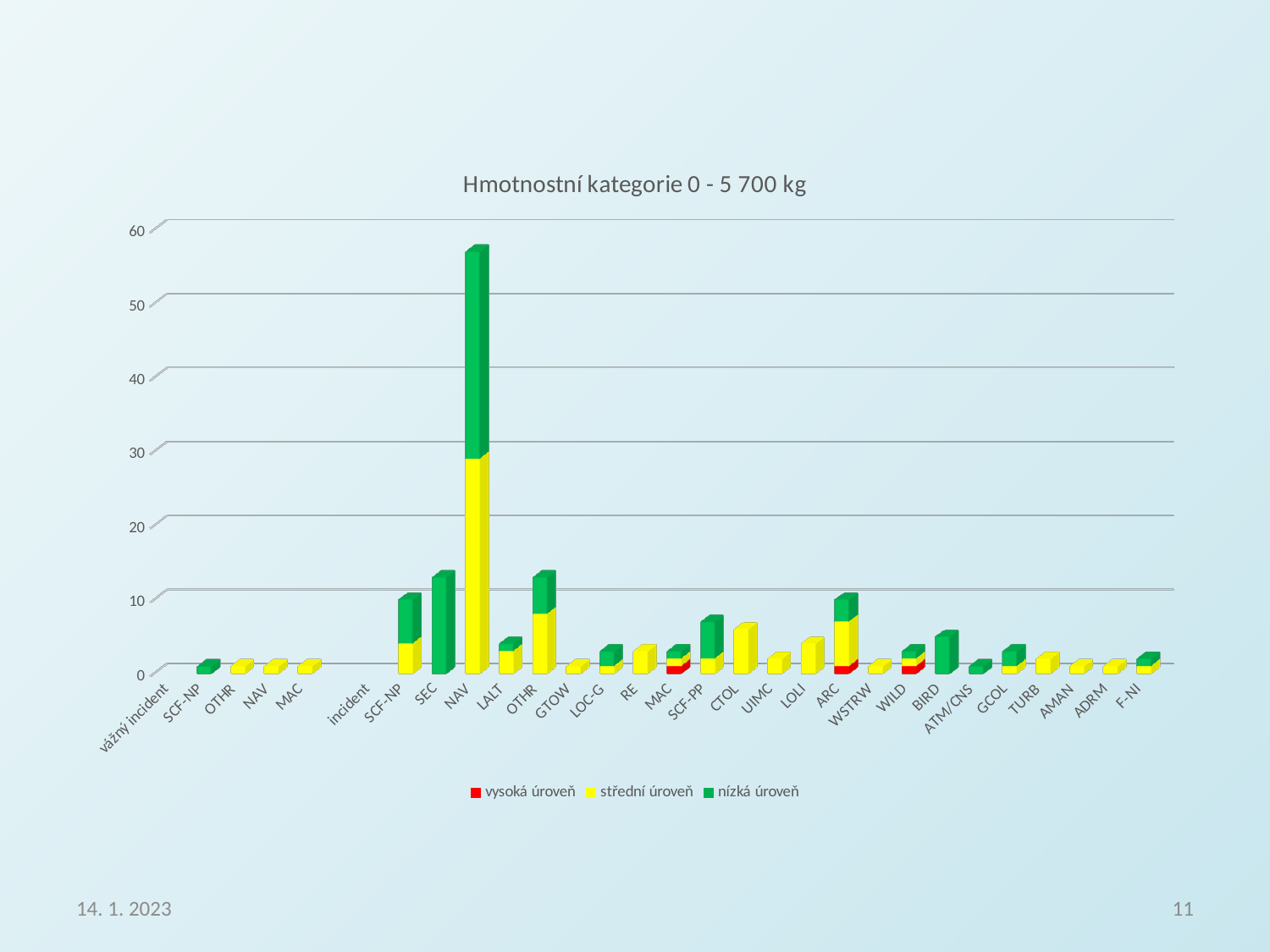
Which bar is taller, NAV in the incident group or SEC? NAV Is the total value for SEC in the incident group greater or less than 10? greater Which series is shown in red in the legend? vysoká úroveň Is the total value for CTOL greater or less than 10? less Which category has the tallest bar in the chart? NAV (in the incident group) Is the total value for OTHR in the incident group greater or less than 10? greater What is the title of the chart? Hmotnostní kategorie 0 - 5 700 kg What type of chart is shown on the slide? stacked bar chart How many series does the legend list? 3 Which bar is taller, SEC or LALT? SEC